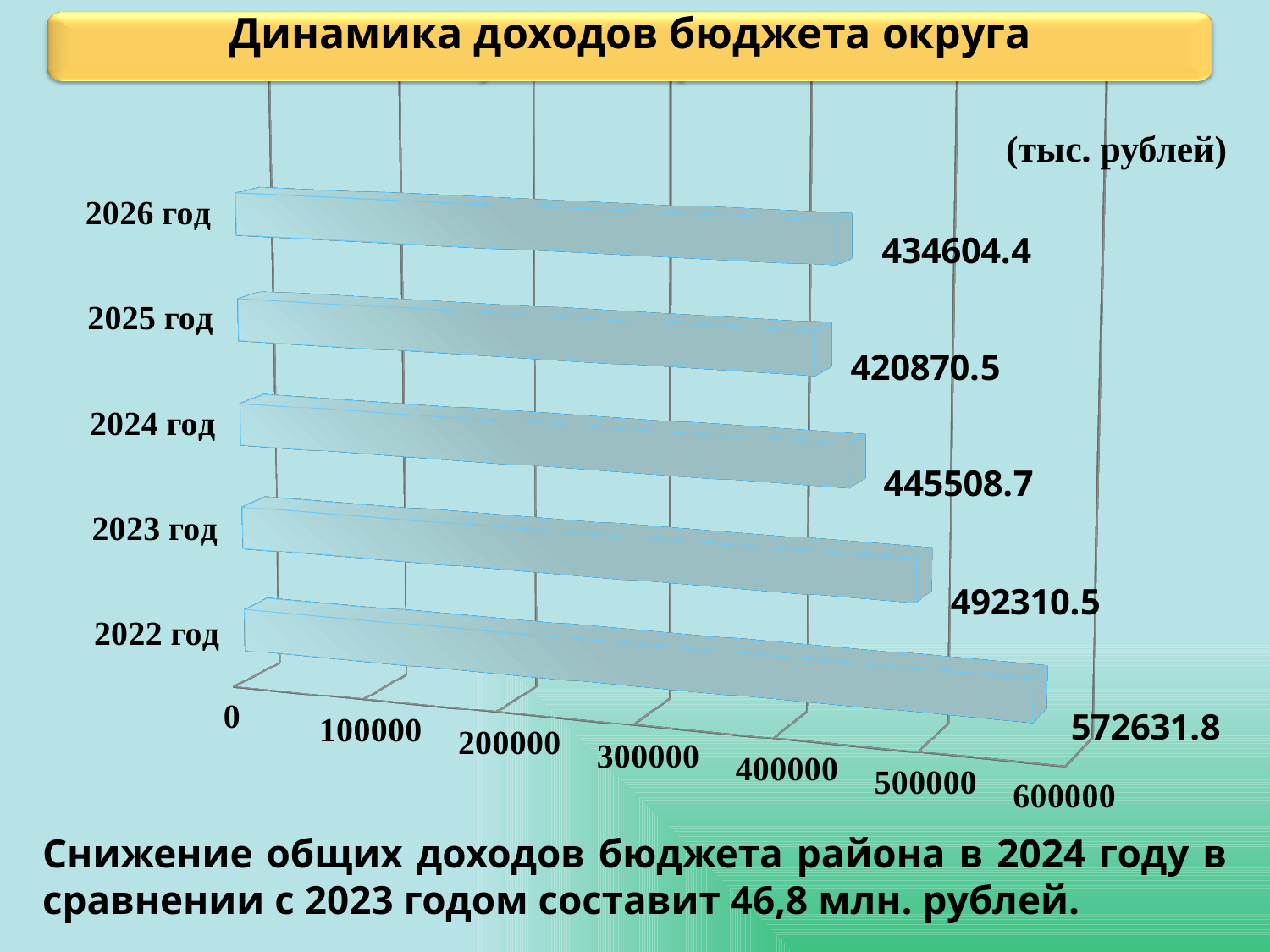
Is the value for 2022 год greater or less than 500000? greater What kind of chart is shown on the slide? bar chart Which year has the highest value? 2022 год Which is larger, the value for 2025 год or the value for 2026 год? 2026 год What is the difference between the values for 2022 год and 2023 год? 80321.3 Which year has the lowest value? 2025 год How many years are shown in the chart? 5 What is the difference between the values for 2023 год and 2024 год? 46801.8 What is the title of the chart? Динамика доходов бюджета округа What is the value for 2024 год? 445508.7 What is the value for 2022 год? 572631.8 What is the value for 2026 год? 434604.4